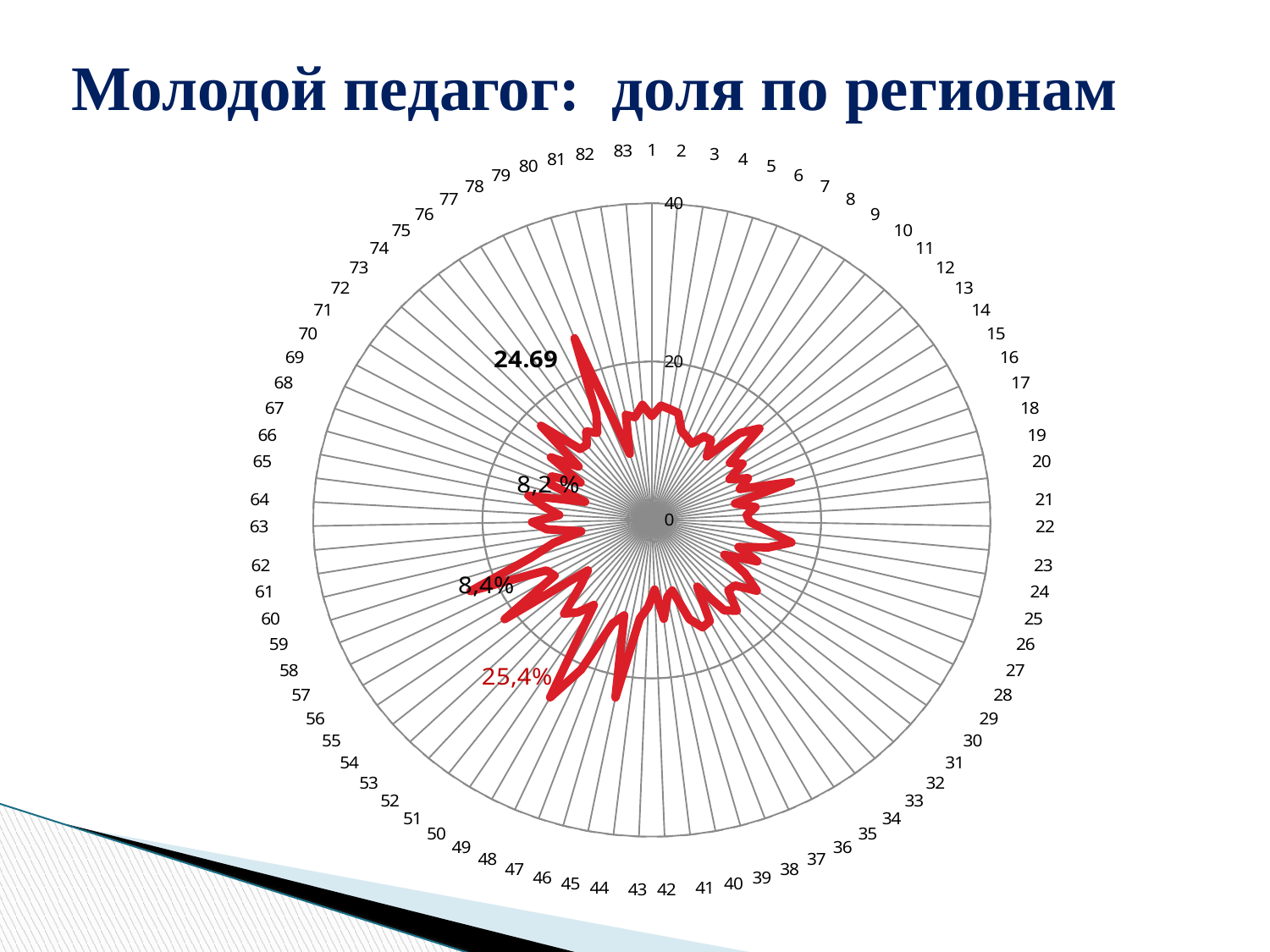
How many regions (categories) are plotted around the radar chart? 83 What is the highest value shown on the radial axis of the chart? 40 Is the value for region 63 greater or less than 20? less Is the value for region 1 greater or less than 40? less Is the value for region 1 greater or less than 20? less What kind of chart is shown on the slide? radar chart What is the title of the chart on the slide? Молодой педагог: доля по регионам How many data series are plotted on the radar chart? 1